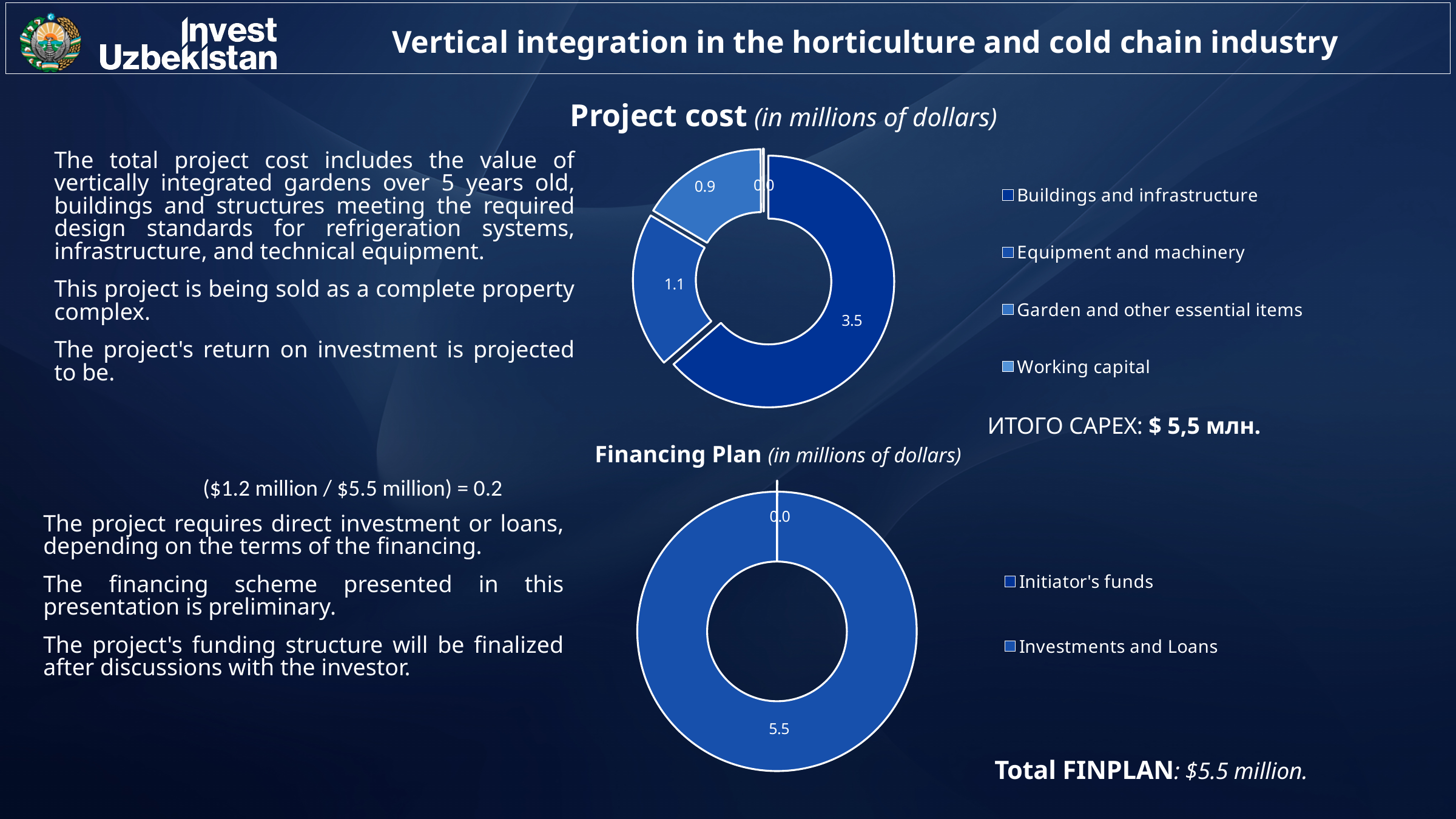
How many categories does the legend of the Financing Plan chart list? 2 In the Project cost chart, what is the difference between Buildings and infrastructure and Equipment and machinery? 2.4 In the Project cost chart, what is the value for Garden and other essential items? 0.9 In the Project cost chart, what is the value for Equipment and machinery? 1.1 What kind of chart is the Financing Plan chart? Doughnut chart In the Project cost chart, which is larger: Equipment and machinery or Garden and other essential items? Equipment and machinery In the Financing Plan chart, what is the value for Investments and Loans? 5.5 In the Project cost chart, which category has the smallest value? Working capital In the Project cost chart, which category has the largest value? Buildings and infrastructure How many categories does the legend of the Project cost chart list? 4 In the Project cost chart, what is the value for Buildings and infrastructure? 3.5 In the Financing Plan chart, what is the value for Initiator's funds? 0.0